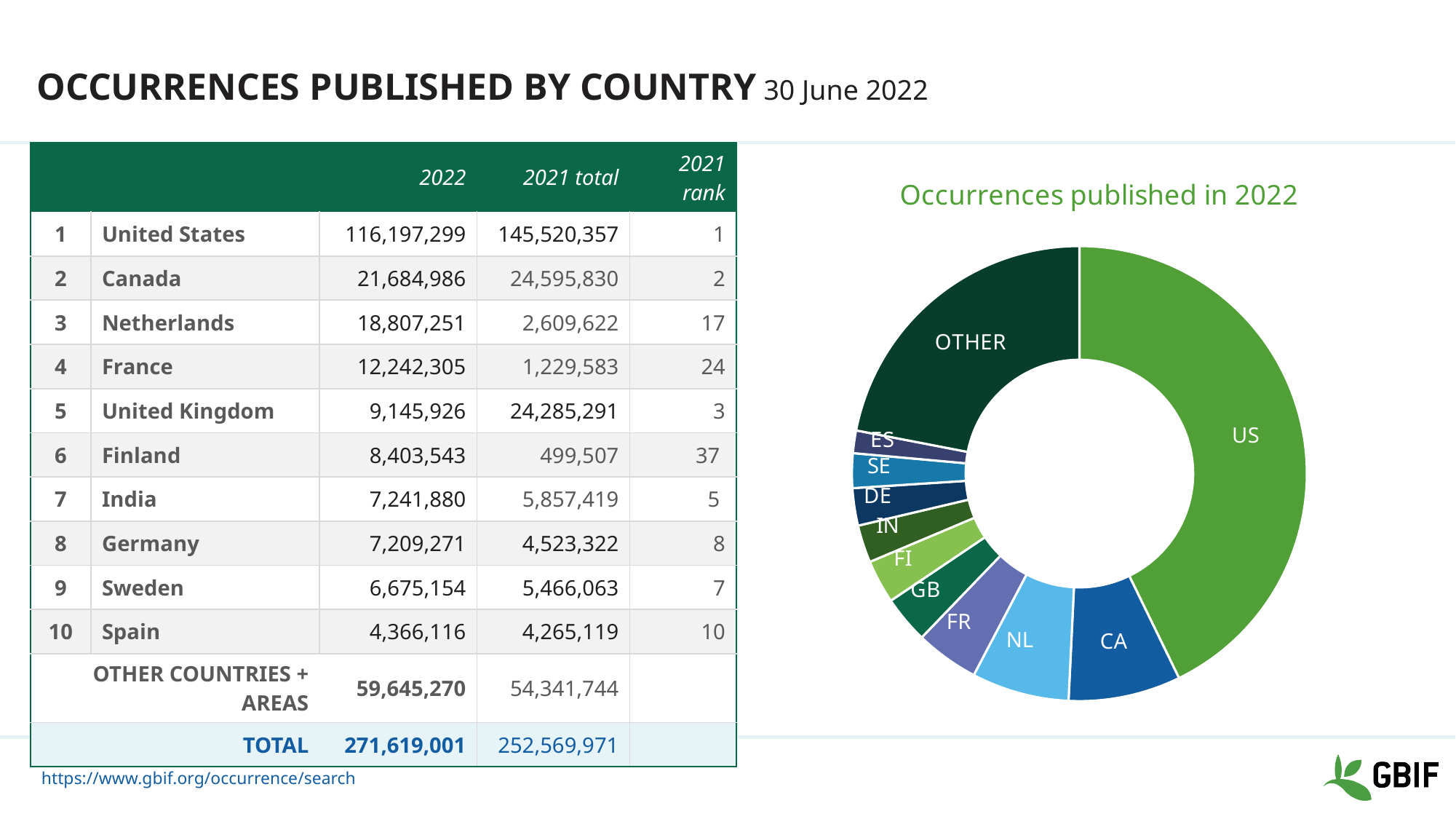
In the donut chart, which slice is larger, FR or GB? FR What colour is the US slice in the donut chart? Green What kind of chart is shown on the right of the slide? Donut (pie) chart Which slice of the donut chart is the largest? US What is the total number of occurrences published in 2022 that the donut chart represents? 271,619,001 How many slices does the donut chart have? 11 According to the slide, how many occurrences does the US slice of the donut chart represent for 2022? 116,197,299 According to the slide, how many occurrences does the OTHER slice of the donut chart represent for 2022? 59,645,270 Which country slice of the donut chart is the smallest? ES What is the title of the chart on the right? Occurrences published in 2022 In the donut chart, which slice is larger, US or OTHER? US In the donut chart, which slice is larger, NL or FI? NL